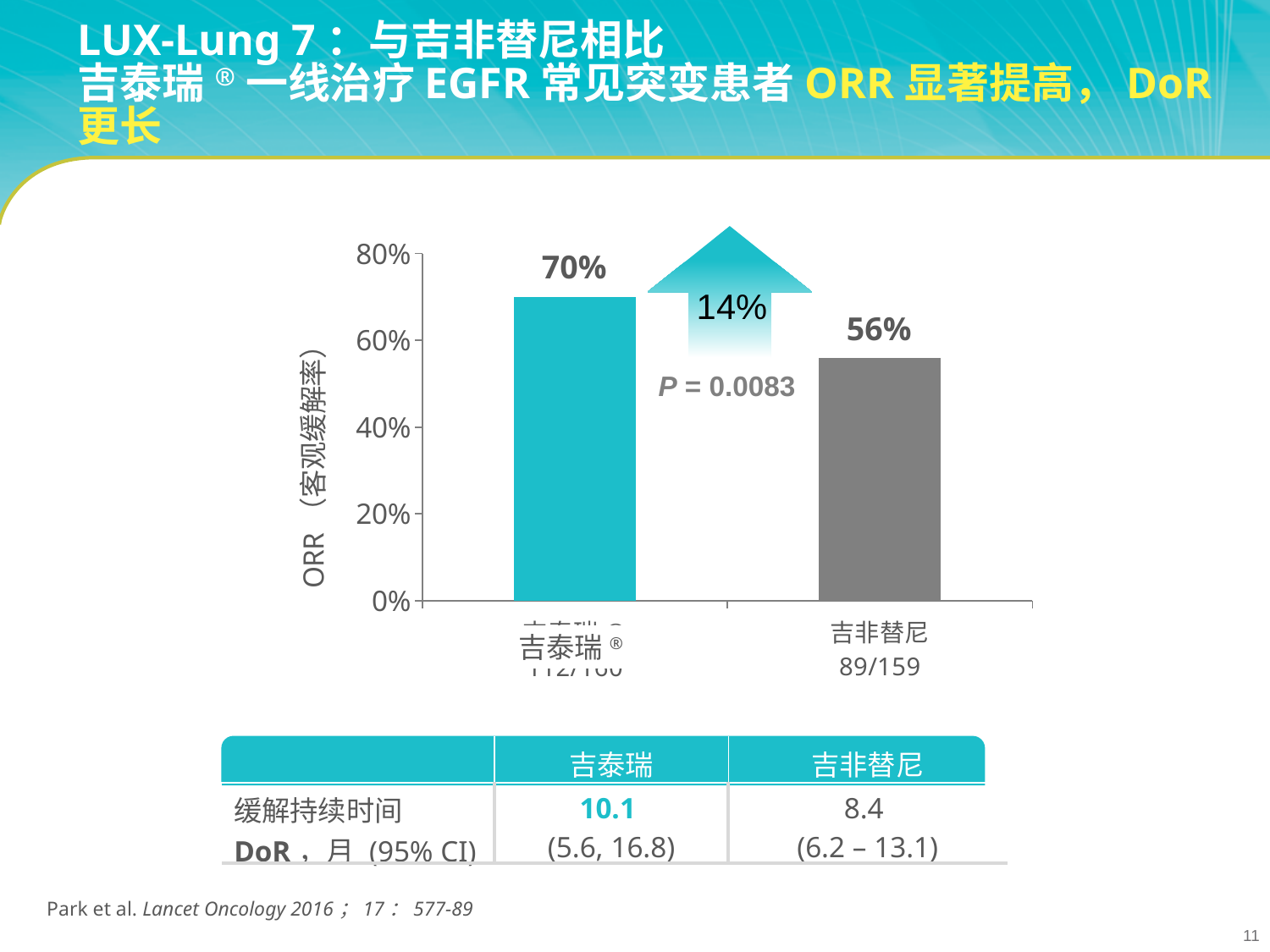
What is the P value shown between the two bars in the chart? P = 0.0083 What is the ORR value shown for 吉非替尼? 56% What is the ORR value shown for 吉泰瑞®? 70% Is the ORR for 吉泰瑞® greater or less than 60%? greater Is the ORR for 吉非替尼 greater or less than 60%? less How many bars are plotted in the chart? 2 What type of chart is shown on the slide? bar chart What is the difference in ORR between 吉泰瑞® and 吉非替尼? 14% Which treatment has the higher ORR in the chart? 吉泰瑞® What is the maximum value shown on the y axis of the chart? 80% Is the ORR for 吉泰瑞® larger or smaller than the ORR for 吉非替尼? larger Which treatment has the lower ORR in the chart? 吉非替尼